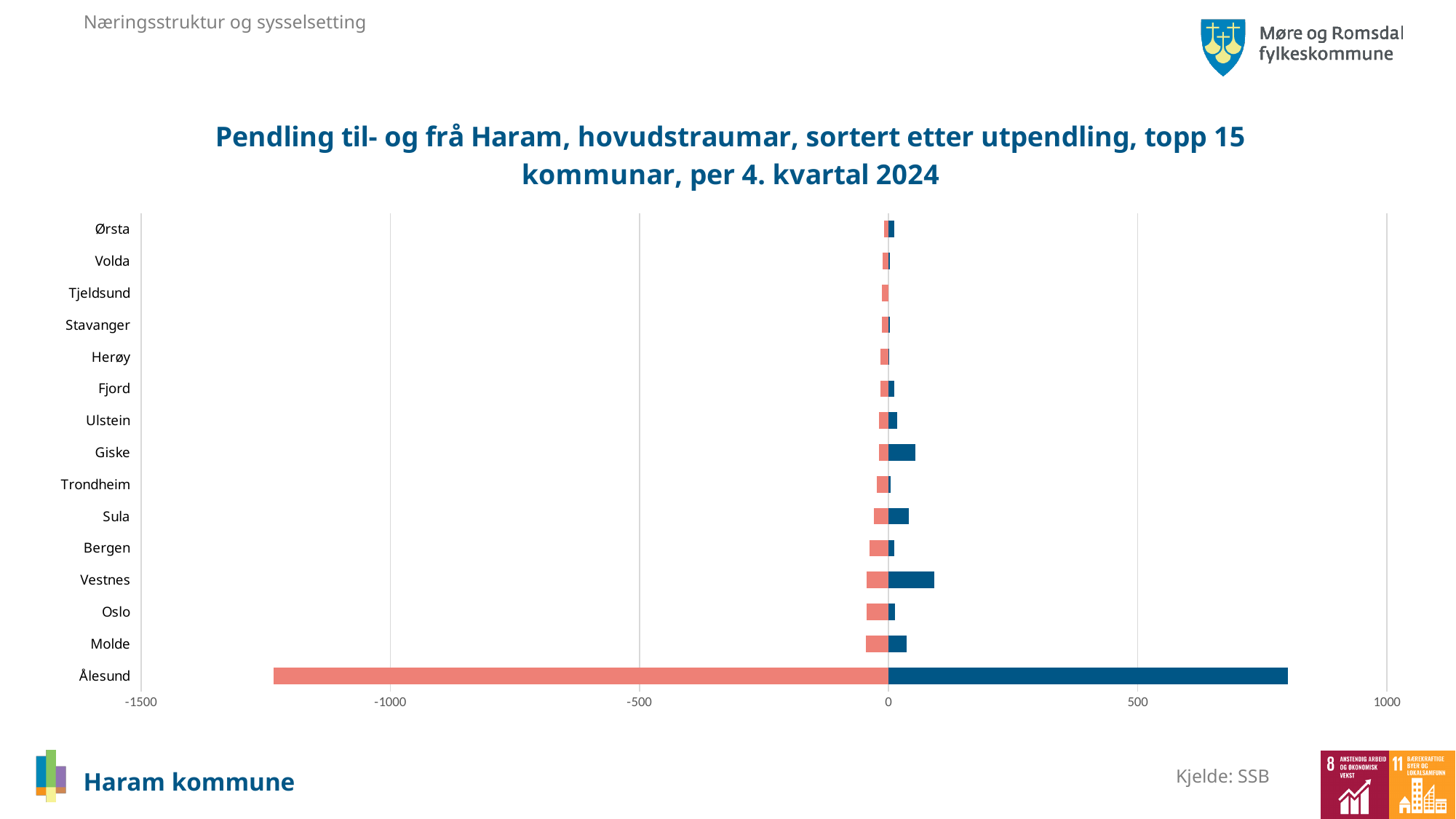
What is the lowest value shown on the horizontal axis? -1500 Is the positive (blue) value for Vestnes greater or less than 500? less Which has the larger positive (blue) bar, Vestnes or Giske? Vestnes Is the positive (blue) value for Ålesund greater or less than 500? greater Is the negative (red) value for Ålesund greater or less than -1000? less Which has the larger positive (blue) bar, Vestnes or Molde? Vestnes How many municipalities (categories) are listed on the vertical axis of the chart? 15 Which municipality has the longest bars in the chart? Ålesund Which municipality is listed at the bottom of the vertical axis? Ålesund What kind of chart is shown on the slide? bar chart Which municipality is listed at the top of the vertical axis? Ørsta